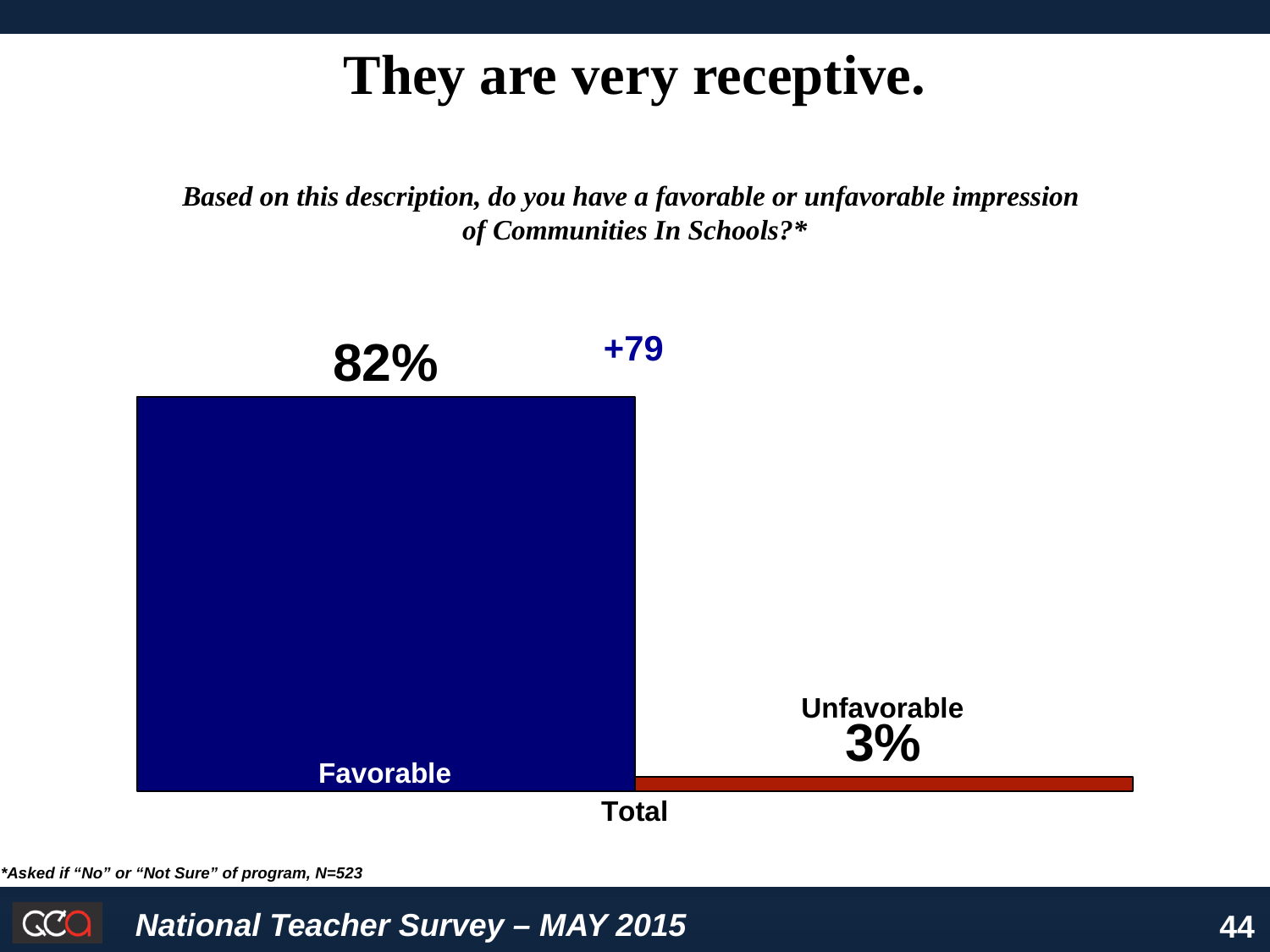
What is the sample size (N) noted in the footnote? N=523 What kind of chart is shown on the slide? Bar chart How many bars are shown in the chart? 2 What net figure is printed above the bars? +79 Which response has the lowest value on the chart? Unfavorable Which response is higher, Favorable or Unfavorable? Favorable What colour is the Favorable bar? Dark blue What percentage of respondents have a favorable impression of Communities In Schools? 82% What is the category label shown beneath the bars? Total What is the difference between the Favorable and Unfavorable percentages? 79% What percentage of respondents have an unfavorable impression of Communities In Schools? 3%